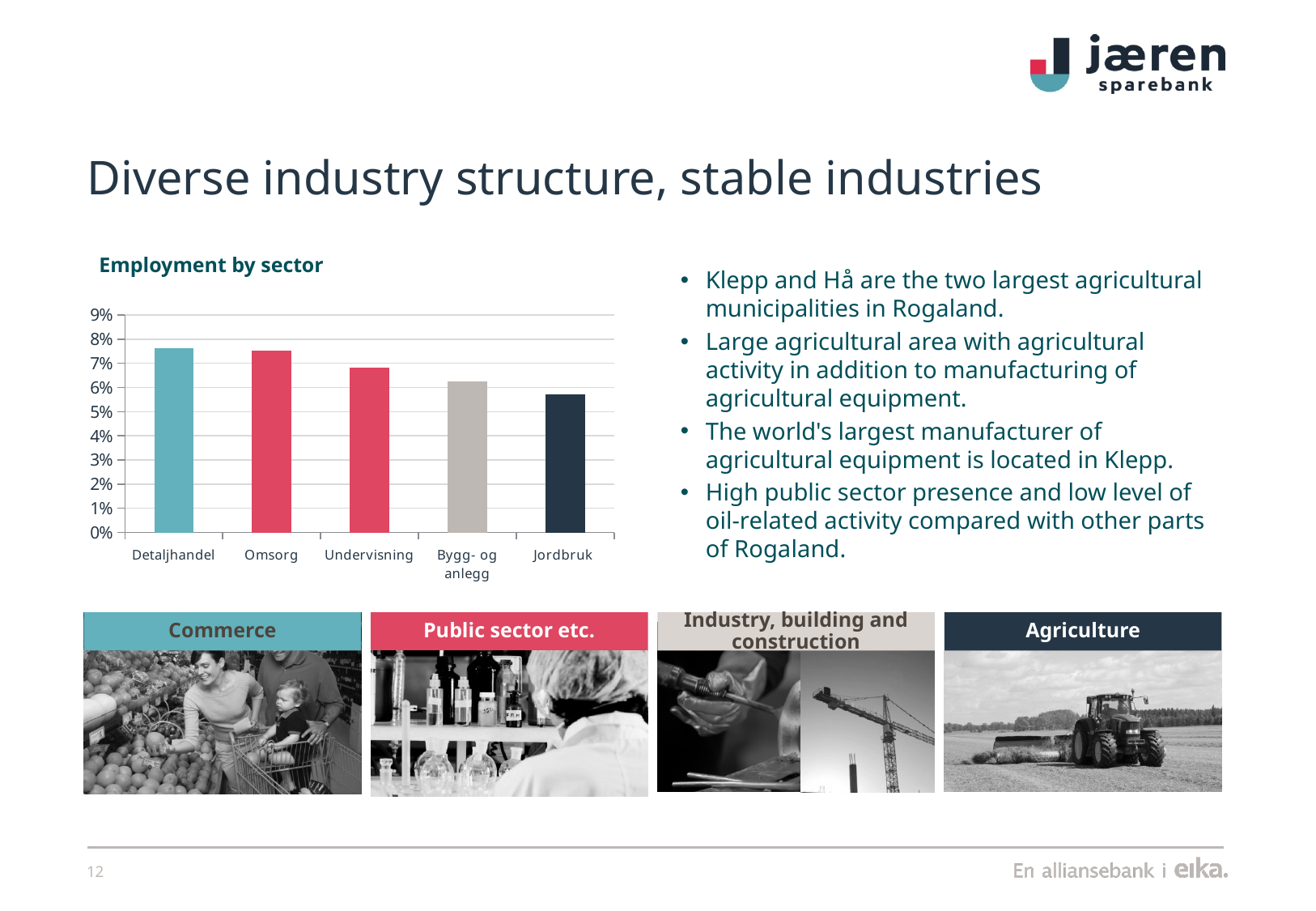
Is the value for Omsorg greater or less than 7%? greater What is the title of the chart on the slide? Employment by sector How many sectors are shown on the x axis of the "Employment by sector" chart? 5 What kind of chart is shown under the title "Employment by sector"? bar chart Is the value for Bygg- og anlegg greater or less than 6%? greater Is the value for Jordbruk greater or less than 6%? less Do the values in the "Employment by sector" chart rise or fall from left to right along the x axis? fall Which is larger, the value for Undervisning or the value for Jordbruk? Undervisning Which sector has the lowest employment share in the "Employment by sector" chart? Jordbruk Which is larger, the value for Detaljhandel or the value for Bygg- og anlegg? Detaljhandel